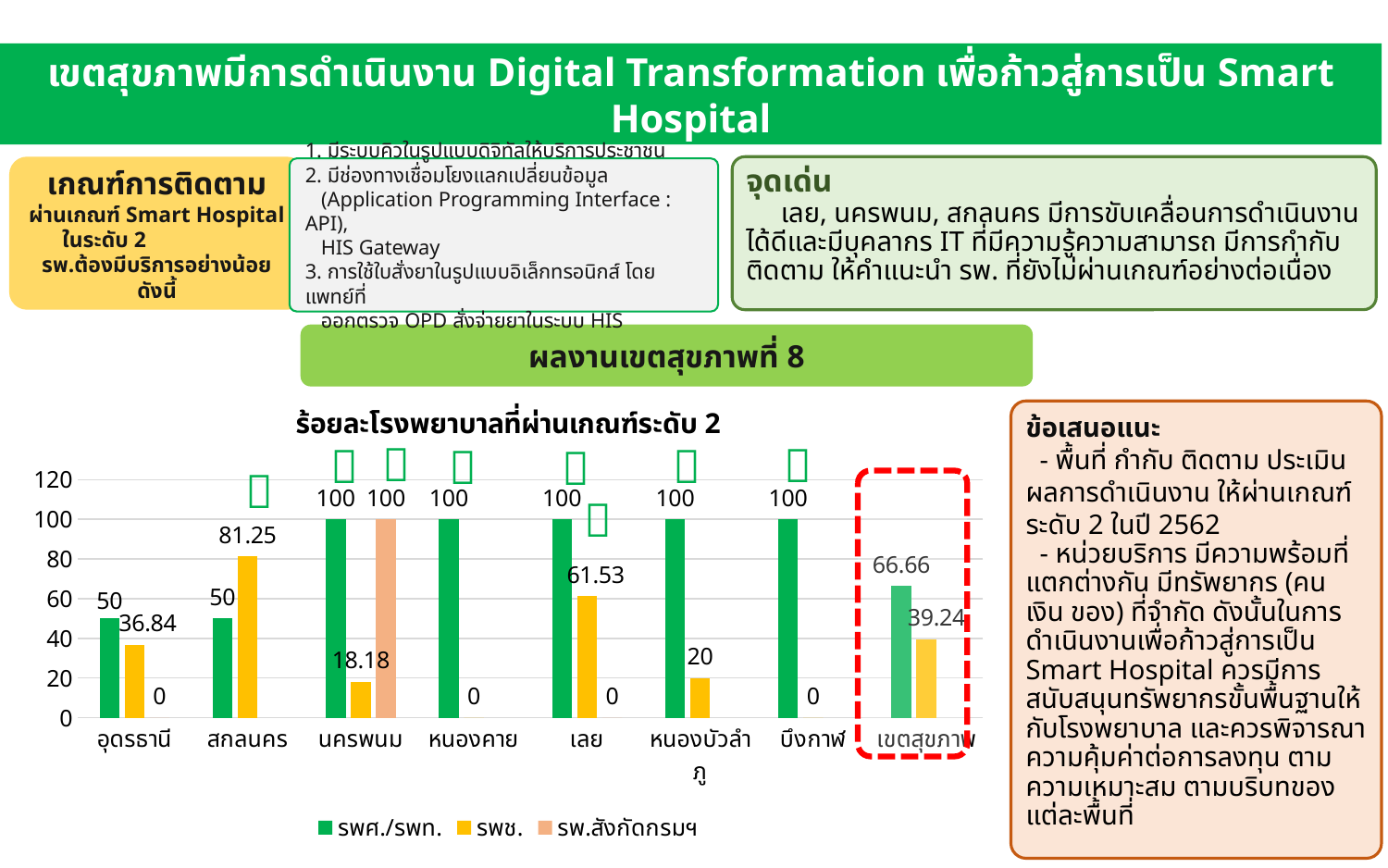
What is the value for รพช. in เลย? 61.53 Which category has the highest value for รพช.? สกลนคร What is the difference between the รพศ./รพท. value and the รพช. value in เขตสุขภาพ? 27.42 What type of chart is shown on the slide? bar chart What is the value for รพช. in นครพนม? 18.18 How many categories are shown on the x axis of the chart? 8 What is the value for รพช. in หนองบัวลำภู? 20 What is the title of the chart? ร้อยละโรงพยาบาลที่ผ่านเกณฑ์ระดับ 2 Which is larger in อุดรธานี: the value for รพศ./รพท. or the value for รพช.? รพศ./รพท. What is the value for รพศ./รพท. in เขตสุขภาพ? 66.66 How many series does the chart legend list? 3 What is the value for รพช. in สกลนคร? 81.25